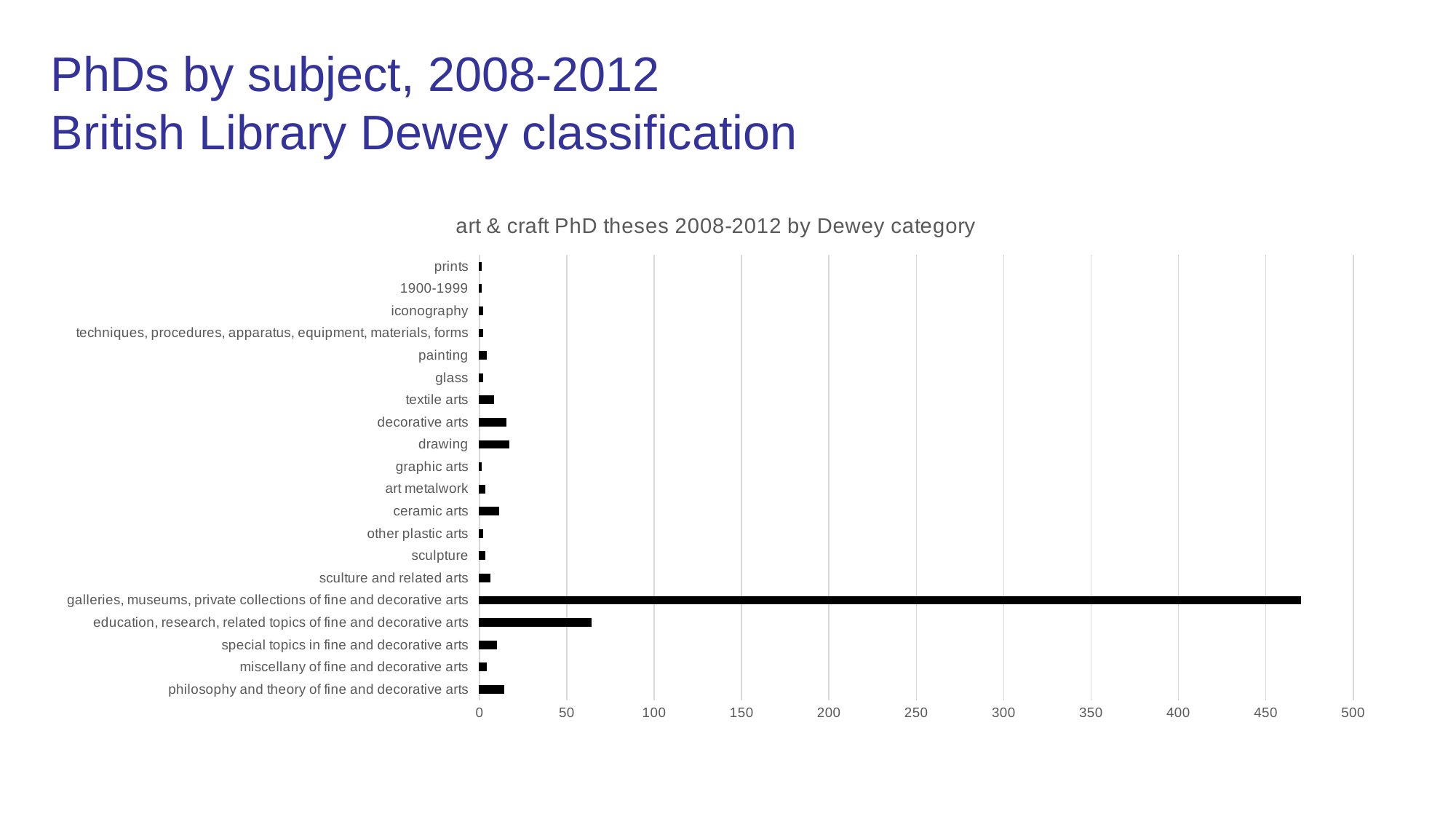
Which is larger, the value for philosophy and theory of fine and decorative arts or the value for miscellany of fine and decorative arts? philosophy and theory of fine and decorative arts What is the title of the chart? art & craft PhD theses 2008-2012 by Dewey category Which category has the highest value? galleries, museums, private collections of fine and decorative arts Is the value for drawing greater or less than 50? less What is the highest tick value shown on the horizontal axis? 500 Is the value for education, research, related topics of fine and decorative arts greater or less than 100? less Which is larger, the value for drawing or the value for textile arts? drawing Is the value for galleries, museums, private collections of fine and decorative arts greater or less than 450? greater What kind of chart is shown on the slide? bar chart How many categories are plotted in the chart? 20 Which is larger, the value for education, research, related topics of fine and decorative arts or the value for drawing? education, research, related topics of fine and decorative arts